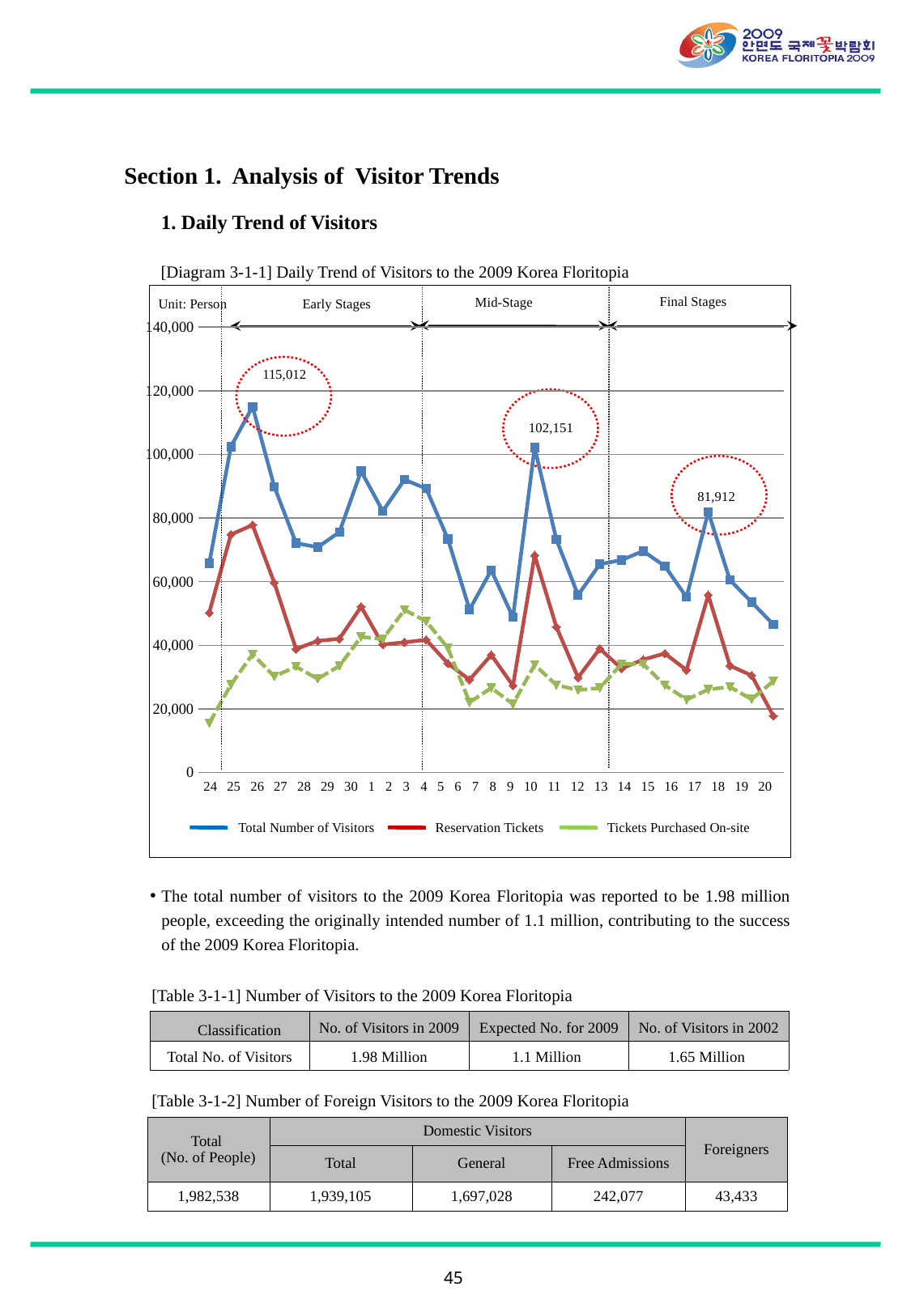
How many series does the legend of the chart list? 3 What is the Total Number of Visitors on day 26 according to the data label? 115,012 Which is larger: the Total Number of Visitors on day 10 or on day 17? Day 10 On which day does the Total Number of Visitors reach its highest value? 26 What type of chart is shown in Diagram 3-1-1? Line chart What is the Total Number of Visitors on day 10 according to the data label? 102,151 How many days are plotted along the x axis of the chart? 27 Is the Total Number of Visitors on day 24 greater or less than 80,000? less What unit is stated for the values in the chart? Person Is the value for Reservation Tickets on day 26 greater or less than 60,000? greater What is the difference between the labelled Total Number of Visitors on day 26 and on day 10? 12,861 What is the Total Number of Visitors on day 17 according to the data label? 81,912